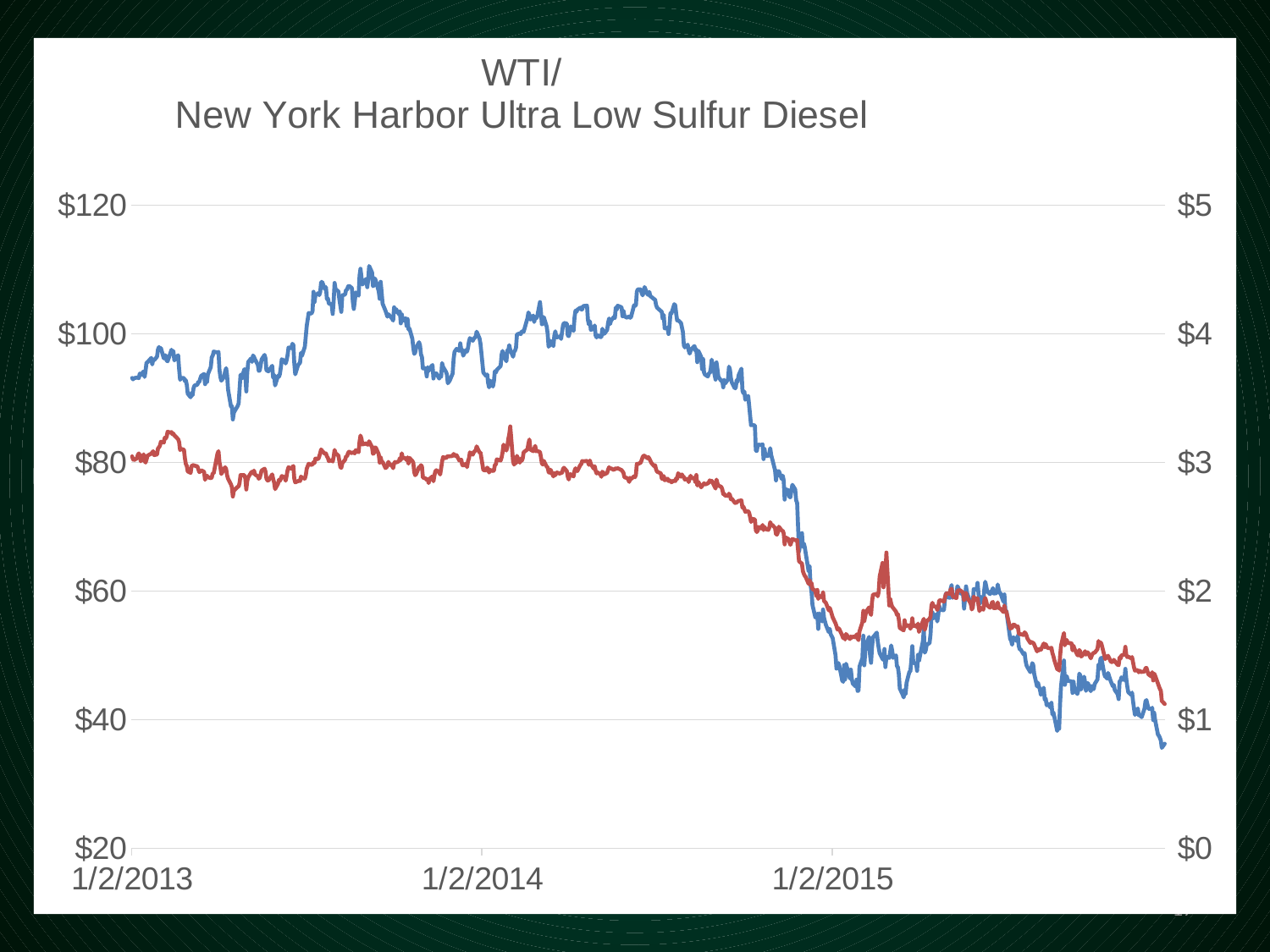
Overall, do the plotted values rise or fall from 1/2/2013 to the end of the series? fall Is the value of the red line at the end of the series greater or less than $2 on the right axis? less Is the peak of the blue line during 2013 greater or less than $100 on the left axis? greater What is the title of the chart? WTI/ New York Harbor Ultra Low Sulfur Diesel How many lines are plotted on the chart? 2 Is the value of the blue line at 1/2/2013 greater or less than $80 on the left axis? greater What is the highest value shown on the left vertical axis? $120 What is the highest value shown on the right vertical axis? $5 How many date labels are shown on the x axis? 3 What kind of chart is shown on the slide? line chart